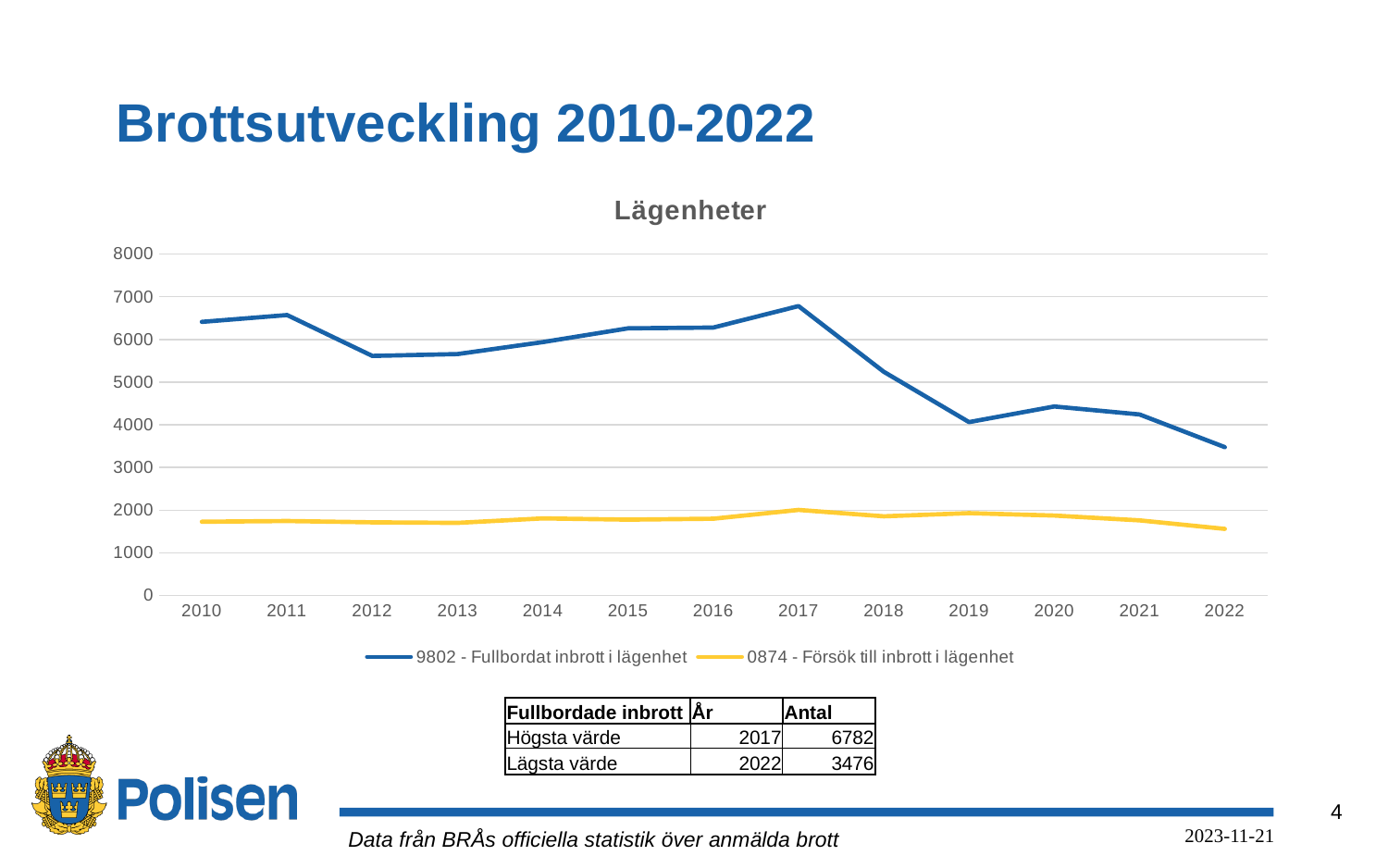
What kind of chart is shown on the slide? line chart How many series does the chart legend list? 2 Is the value for '9802 - Fullbordat inbrott i lägenhet' in 2019 greater or less than 5000? less Which series has the larger value in 2010, '9802 - Fullbordat inbrott i lägenhet' or '0874 - Försök till inbrott i lägenhet'? 9802 - Fullbordat inbrott i lägenhet What is the title of the chart? Lägenheter How many years are shown on the x axis of the chart? 13 What is the difference between the highest (2017) and lowest (2022) values of '9802 - Fullbordat inbrott i lägenhet'? 3306 In which year does the series '9802 - Fullbordat inbrott i lägenhet' reach its lowest value? 2022 What is the value of '9802 - Fullbordat inbrott i lägenhet' in 2017? 6782 Is the value for '0874 - Försök till inbrott i lägenhet' in 2017 greater or less than 1000? greater What is the value of '9802 - Fullbordat inbrott i lägenhet' in 2022? 3476 In which year does the series '9802 - Fullbordat inbrott i lägenhet' reach its highest value? 2017